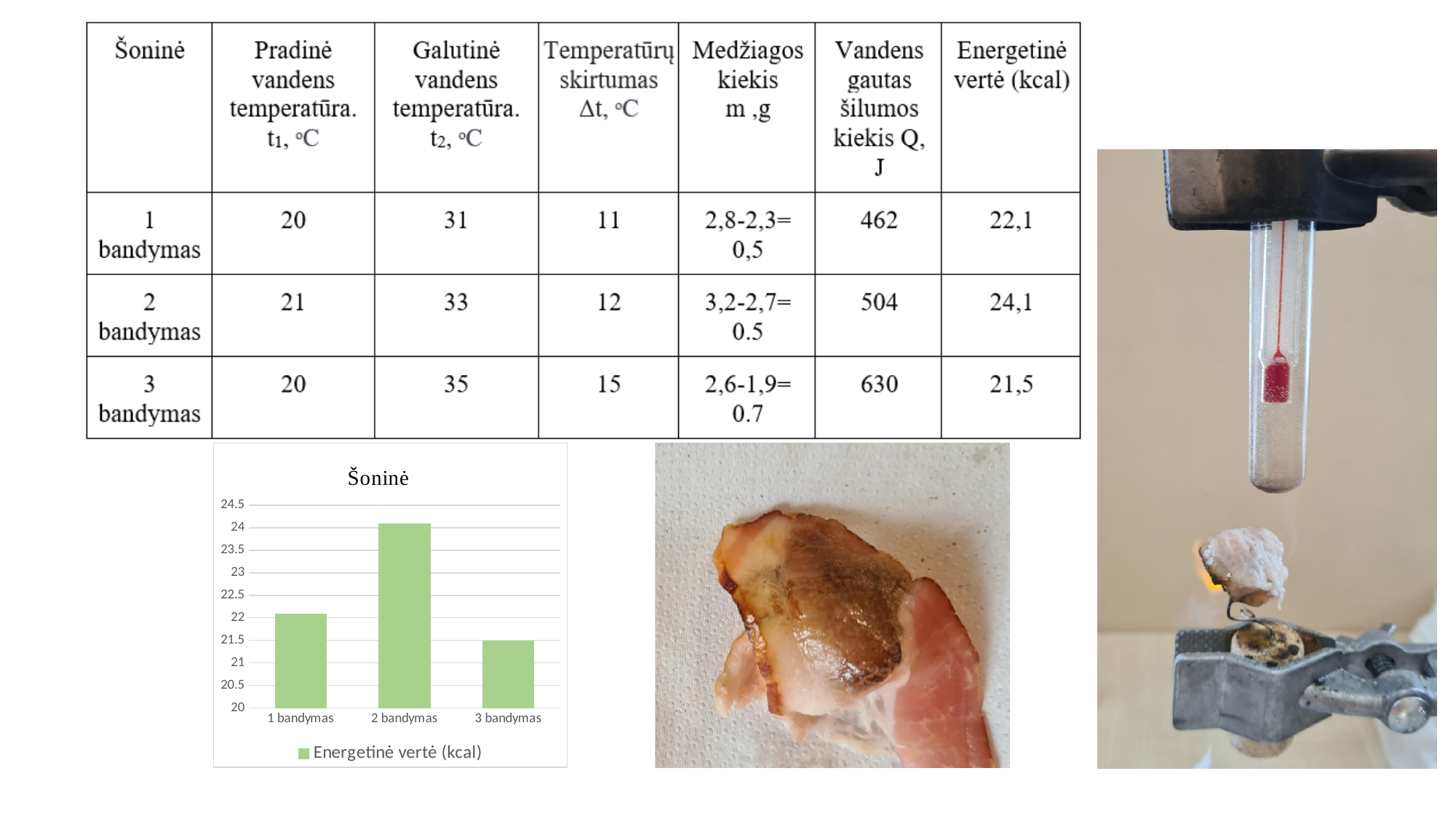
What is the title of the chart? Šoninė Which bandymas has the highest bar in the chart? 2 bandymas What kind of chart is shown on the slide? bar chart Is the value for 1 bandymas greater or less than 22.5? less How many bars does the chart have? 3 What series name is shown in the chart legend? Energetinė vertė (kcal) How many series does the chart legend list? 1 Is the value for 2 bandymas greater or less than 23.5? greater Which is larger in the chart, the value for 2 bandymas or 1 bandymas? 2 bandymas Which bandymas has the lowest bar in the chart? 3 bandymas Which is larger in the chart, the value for 1 bandymas or 3 bandymas? 1 bandymas Is the value for 3 bandymas greater or less than 22? less